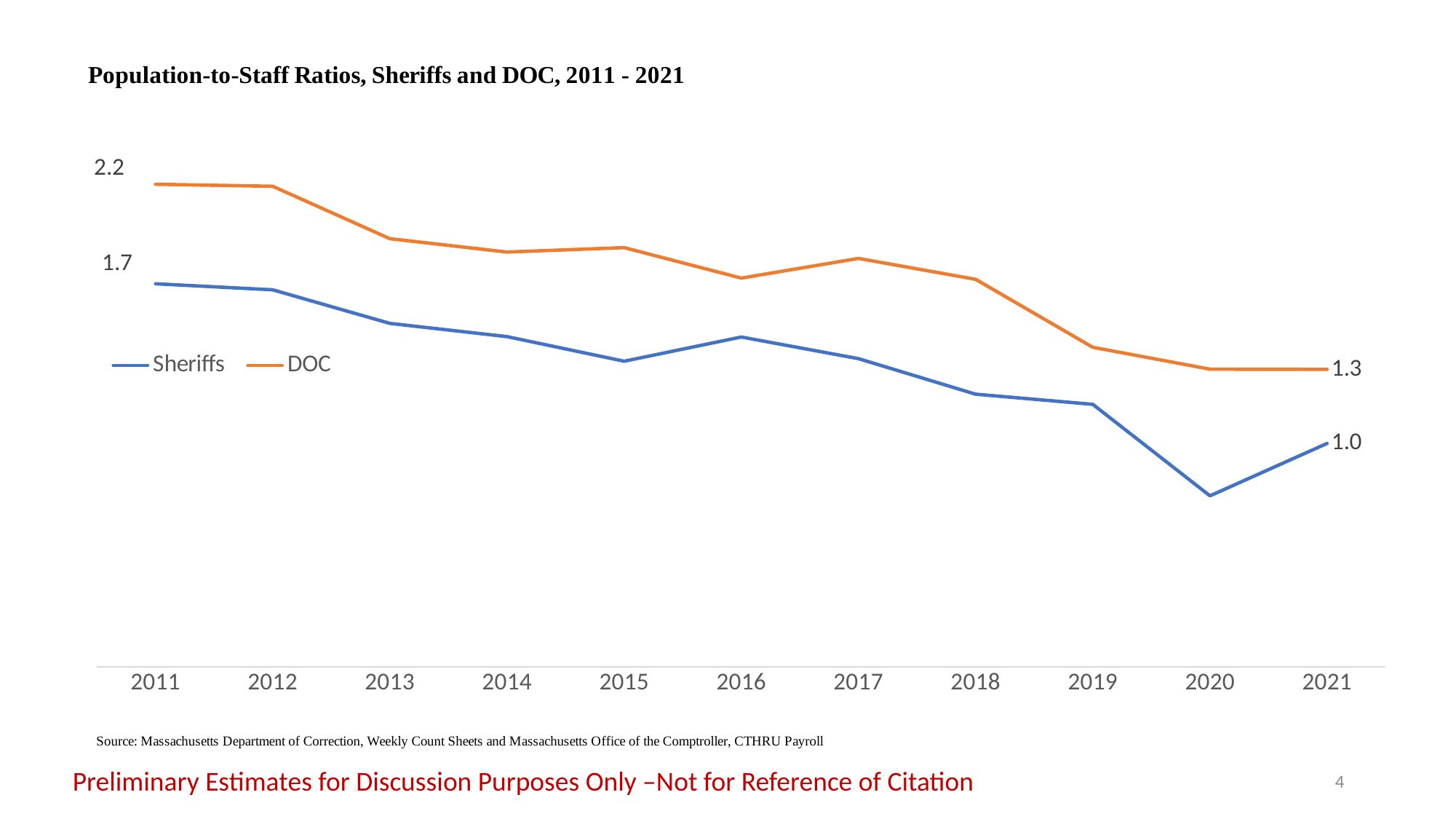
What is the Sheriffs population-to-staff ratio in 2011? 1.7 What is the Sheriffs population-to-staff ratio in 2021? 1.0 What is the DOC population-to-staff ratio in 2021? 1.3 What kind of chart is shown on the slide? Line chart How many years are plotted along the x axis? 11 What is the DOC population-to-staff ratio in 2011? 2.2 In which year is the Sheriffs ratio at its lowest? 2020 What is the difference between the DOC and Sheriffs ratios in 2011? 0.4 By how much did the DOC ratio fall from 2011 to 2021? 0.8 Which series has the higher ratio in 2021, Sheriffs or DOC? DOC Do the Sheriffs ratios generally rise or fall from 2011 to 2021? Fall How many series does the legend list? 2